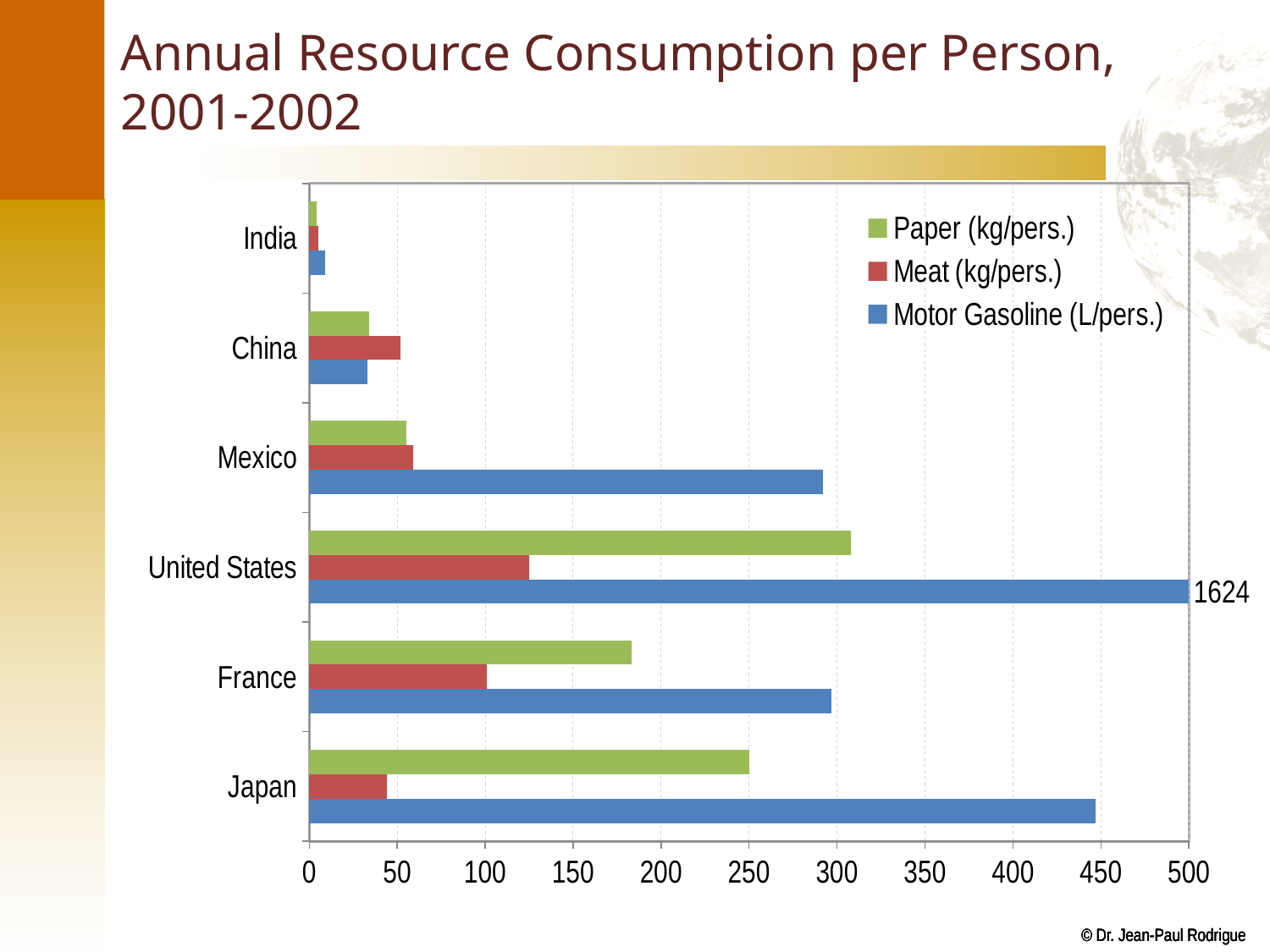
Is the Motor Gasoline (L/pers.) value for Mexico greater or less than 250? greater What is the title of the slide containing the chart? Annual Resource Consumption per Person, 2001-2002 Which country has the highest Paper (kg/pers.) consumption? United States How many series does the legend list? 3 Is the Motor Gasoline (L/pers.) value for Japan greater or less than 400? greater For China, which is larger, the Meat (kg/pers.) value or the Paper (kg/pers.) value? Meat (kg/pers.) What is the Motor Gasoline (L/pers.) value for the United States? 1624 Which is larger, the Paper (kg/pers.) value for Japan or for France? Japan How many countries are shown on the chart? 6 Which country has the lowest Motor Gasoline (L/pers.) consumption? India What kind of chart is shown on the slide? bar chart Which country has the highest Motor Gasoline (L/pers.) consumption? United States